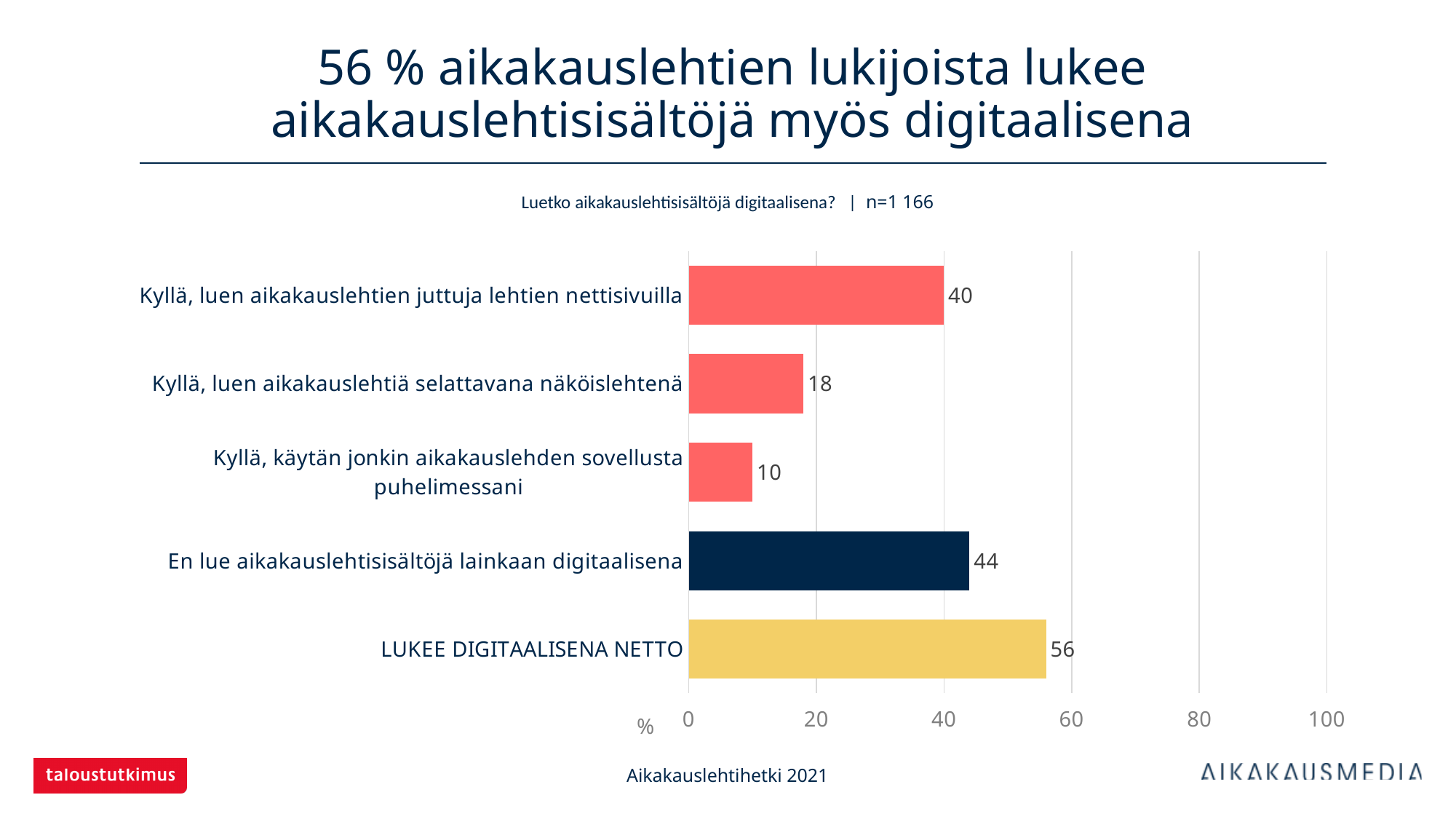
What is the difference between the values for "En lue aikakauslehtisisältöjä lainkaan digitaalisena" and "Kyllä, luen aikakauslehtien juttuja lehtien nettisivuilla"? 4 What is the value for "En lue aikakauslehtisisältöjä lainkaan digitaalisena"? 44 What kind of chart is shown on the slide? Bar chart Which category has the highest value? LUKEE DIGITAALISENA NETTO What is the value for "Kyllä, luen aikakauslehtien juttuja lehtien nettisivuilla"? 40 What is the value for "Kyllä, käytän jonkin aikakauslehden sovellusta puhelimessani"? 10 How many categories are shown in the chart? 5 What is the value for "LUKEE DIGITAALISENA NETTO"? 56 What is the value for "Kyllä, luen aikakauslehtiä selattavana näköislehtenä"? 18 Which is larger: the value for "Kyllä, luen aikakauslehtiä selattavana näköislehtenä" or for "Kyllä, käytän jonkin aikakauslehden sovellusta puhelimessani"? Kyllä, luen aikakauslehtiä selattavana näköislehtenä Which category has the lowest value? Kyllä, käytän jonkin aikakauslehden sovellusta puhelimessani What is the sample size (n) stated above the chart? n=1 166